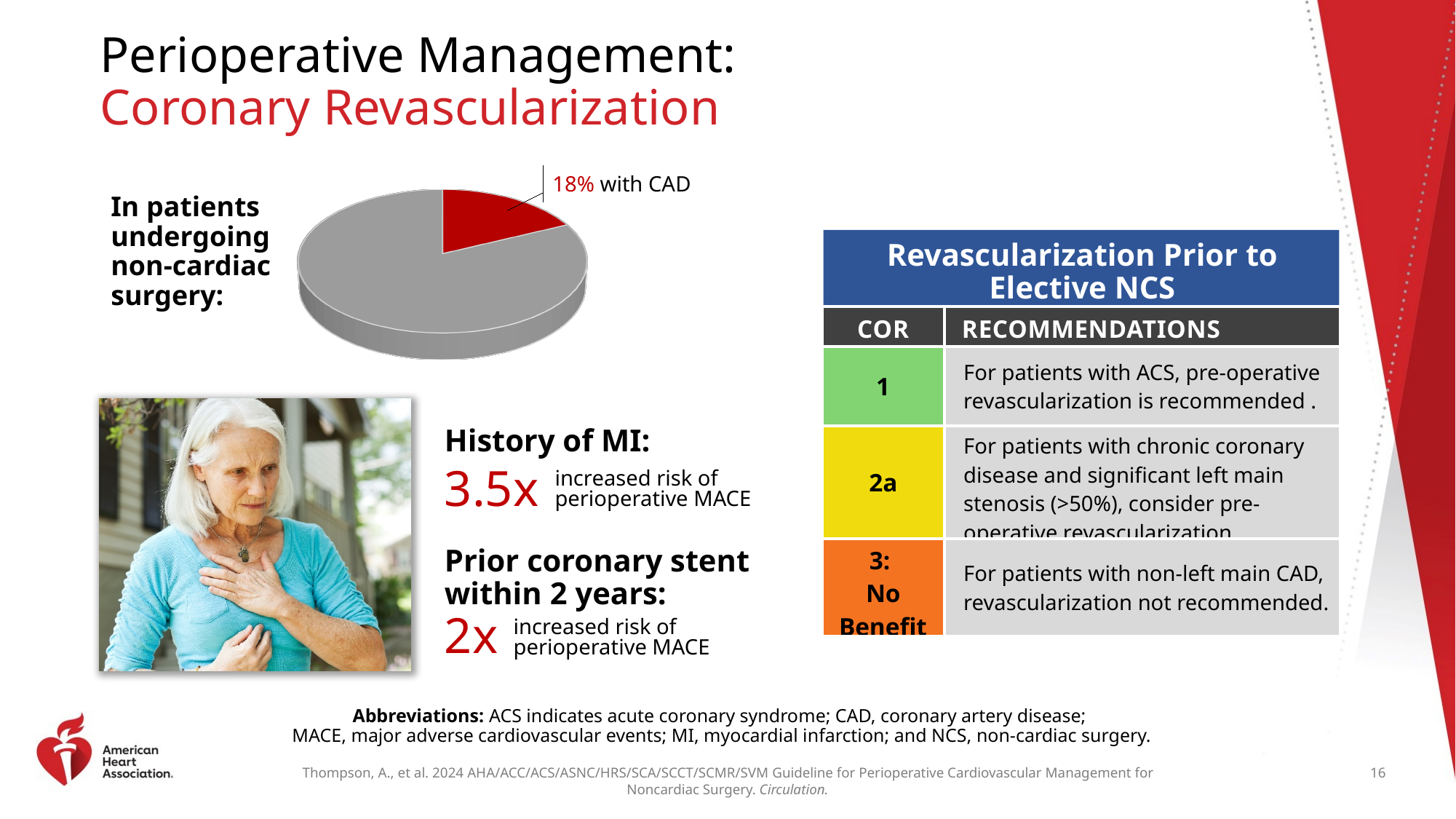
What share of patients undergoing non-cardiac surgery have CAD, according to the pie chart? 18% What kind of chart is shown on the slide? pie chart What share of the pie chart is not labeled as patients with CAD? 82% Which slice of the pie chart is larger: the slice for patients with CAD or the remaining slice? the remaining slice What is the label attached to the red slice of the pie chart? 18% with CAD How many slices does the pie chart have? 2 What colour is the slice representing patients with CAD in the pie chart? red